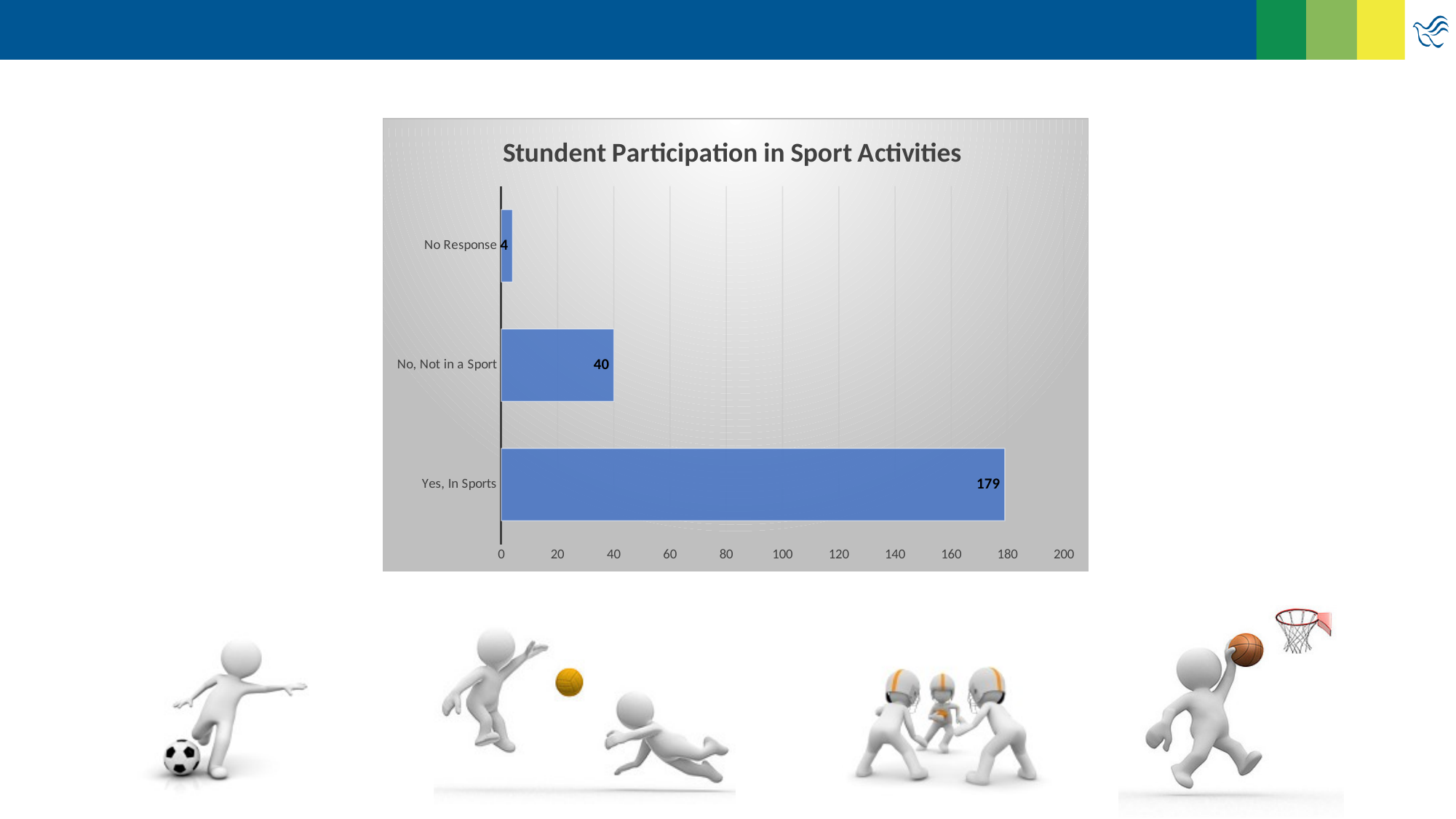
What is the value for "No Response"? 4 What is the value for "No, Not in a Sport"? 40 What kind of chart is shown on the slide? Bar chart Which is larger, the value for "No, Not in a Sport" or the value for "No Response"? No, Not in a Sport How many categories are shown in the chart? 3 Which category has the highest value? Yes, In Sports What is the title of the chart? Stundent Participation in Sport Activities What is the difference between the values for "Yes, In Sports" and "No, Not in a Sport"? 139 Is the value for "Yes, In Sports" greater or less than 160? greater Which category has the lowest value? No Response What is the value for "Yes, In Sports"? 179 What is the difference between the values for "No, Not in a Sport" and "No Response"? 36